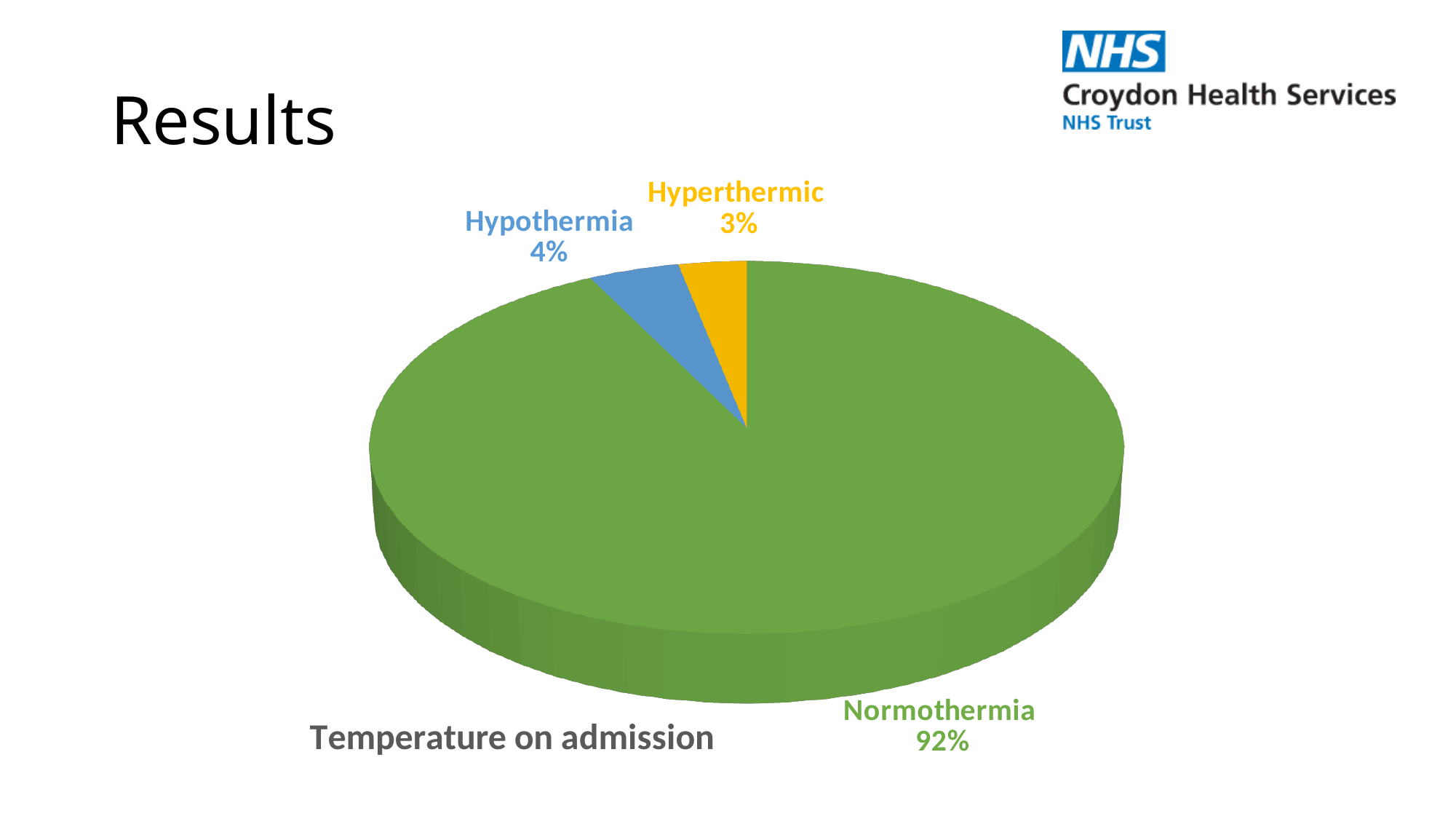
Which category has the largest share of the pie? Normothermia What is the title of the chart? Temperature on admission What is the difference in percentage points between Normothermia and Hypothermia? 88 What percentage of patients were hyperthermic on admission? 3% What is the difference in percentage points between Hypothermia and Hyperthermic? 1 Which is larger, the Hypothermia share or the Hyperthermic share? Hypothermia Which category has the smallest share of the pie? Hyperthermic What colour is the Hypothermia slice? Blue What kind of chart is shown on the slide? Pie chart What percentage of patients had hypothermia on admission? 4% How many categories are shown in the pie chart? 3 What percentage of patients had normothermia on admission? 92%